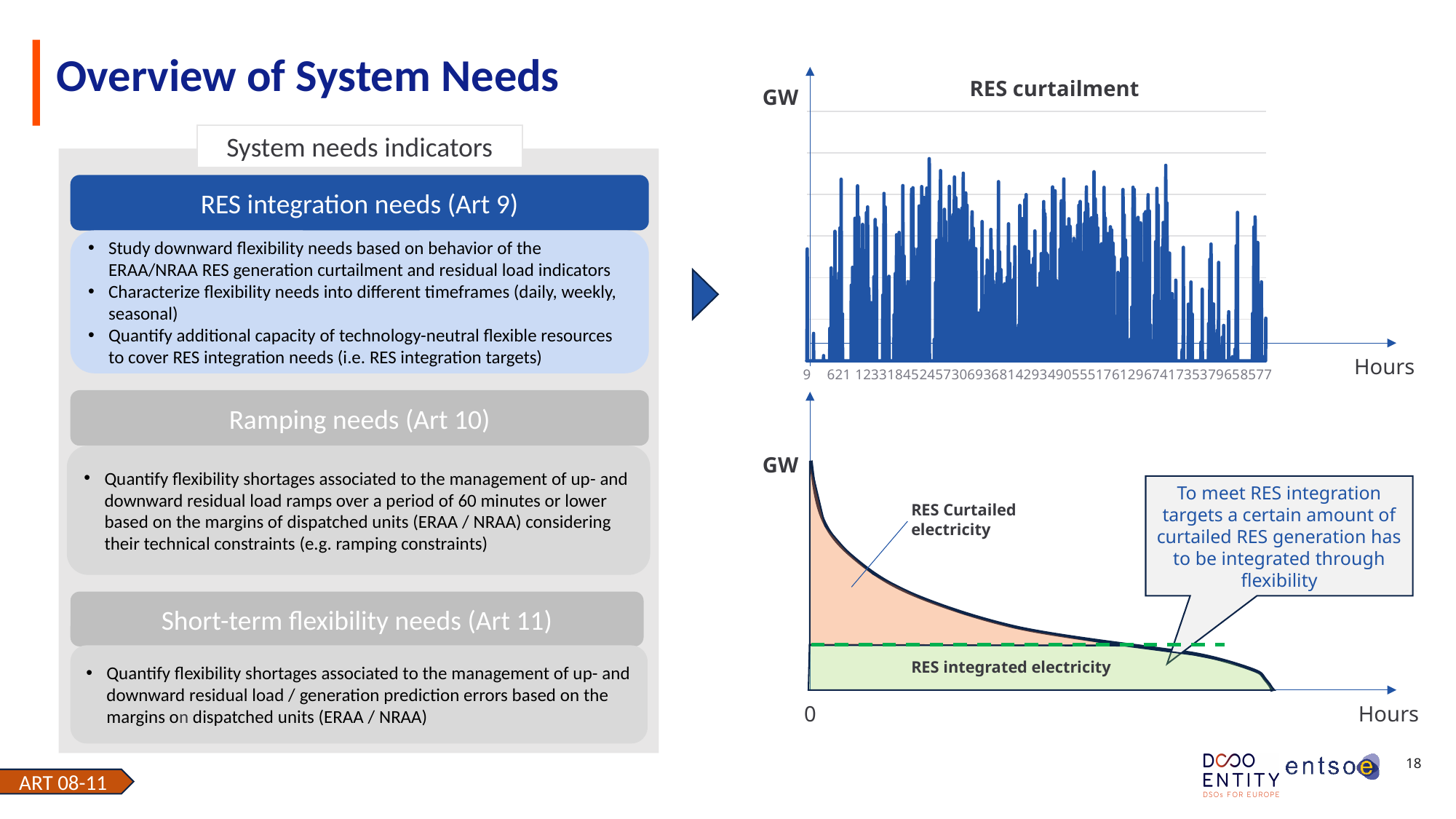
In the bottom chart, do the values rise or fall along the x axis (Hours)? fall What is the title of the top chart on the slide? RES curtailment What kind of chart is the bottom chart on the slide? area chart What kind of chart is the top chart titled "RES curtailment"? bar chart In the bottom chart, what are the two shaded regions labelled? RES Curtailed electricity and RES integrated electricity